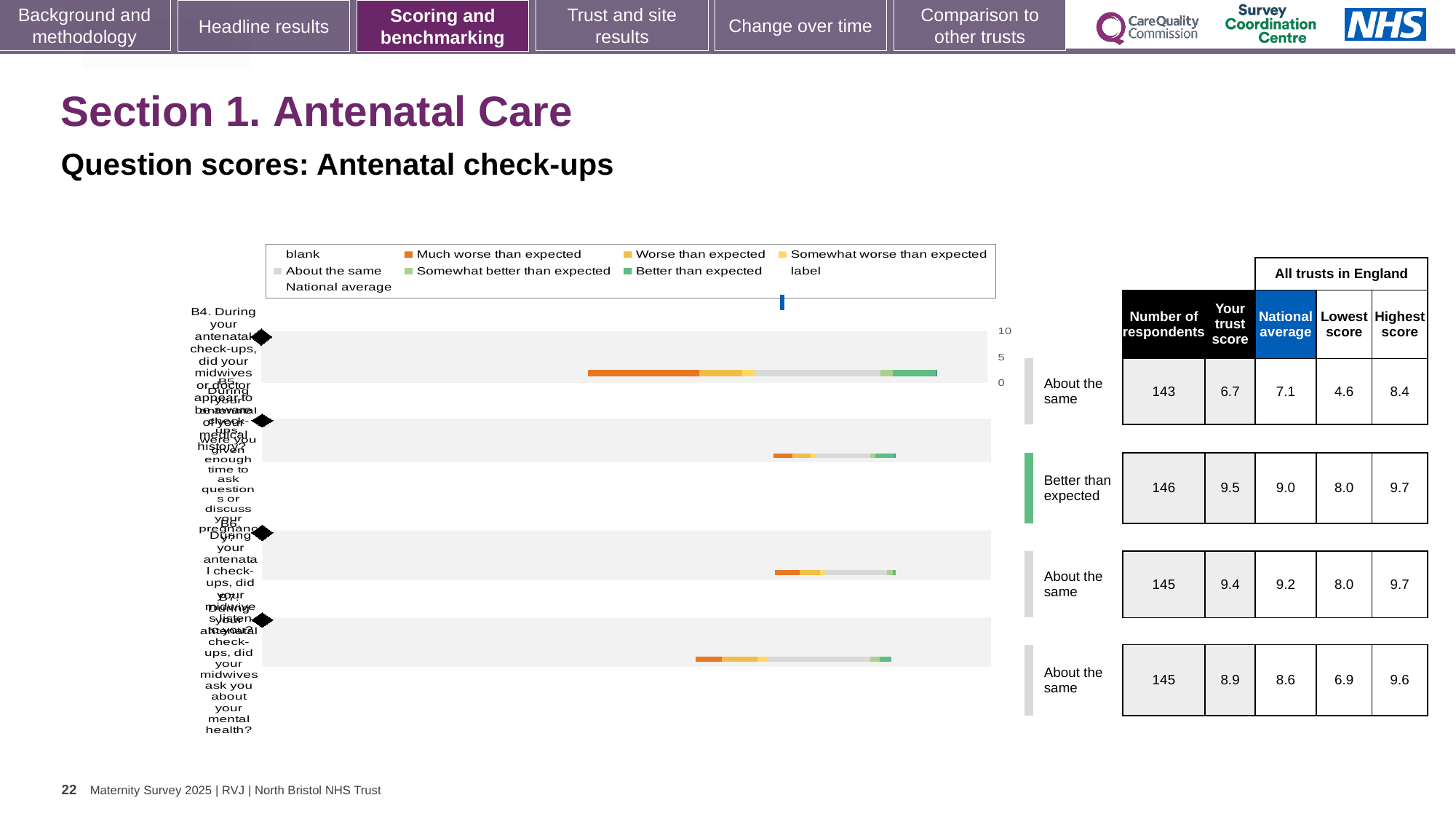
In the chart legend, what colour represents 'Much worse than expected'? orange For question B4 (the top bar), which is larger: the trust score or the national average? national average Which bar (by position from the top) has the highest trust score in the table beside the chart? second For the second bar from the top, what is the difference between the trust score and the national average shown in the table? 0.5 What is the trust score for question B4 (the top bar) in the table beside the chart? 6.7 How many question bars are plotted in the chart? 4 What kind of chart is shown on the slide? bar chart What benchmark category is shown next to the second bar from the top? Better than expected What is the highest score in England for the second bar from the top, according to the table beside the chart? 9.7 What is the national average for question B4 (the top bar) in the table beside the chart? 7.1 Which bar (by position from the top) has the lowest number of respondents in the table beside the chart? first In the table beside the chart, what is the number of respondents for question B4 (the top bar)? 143